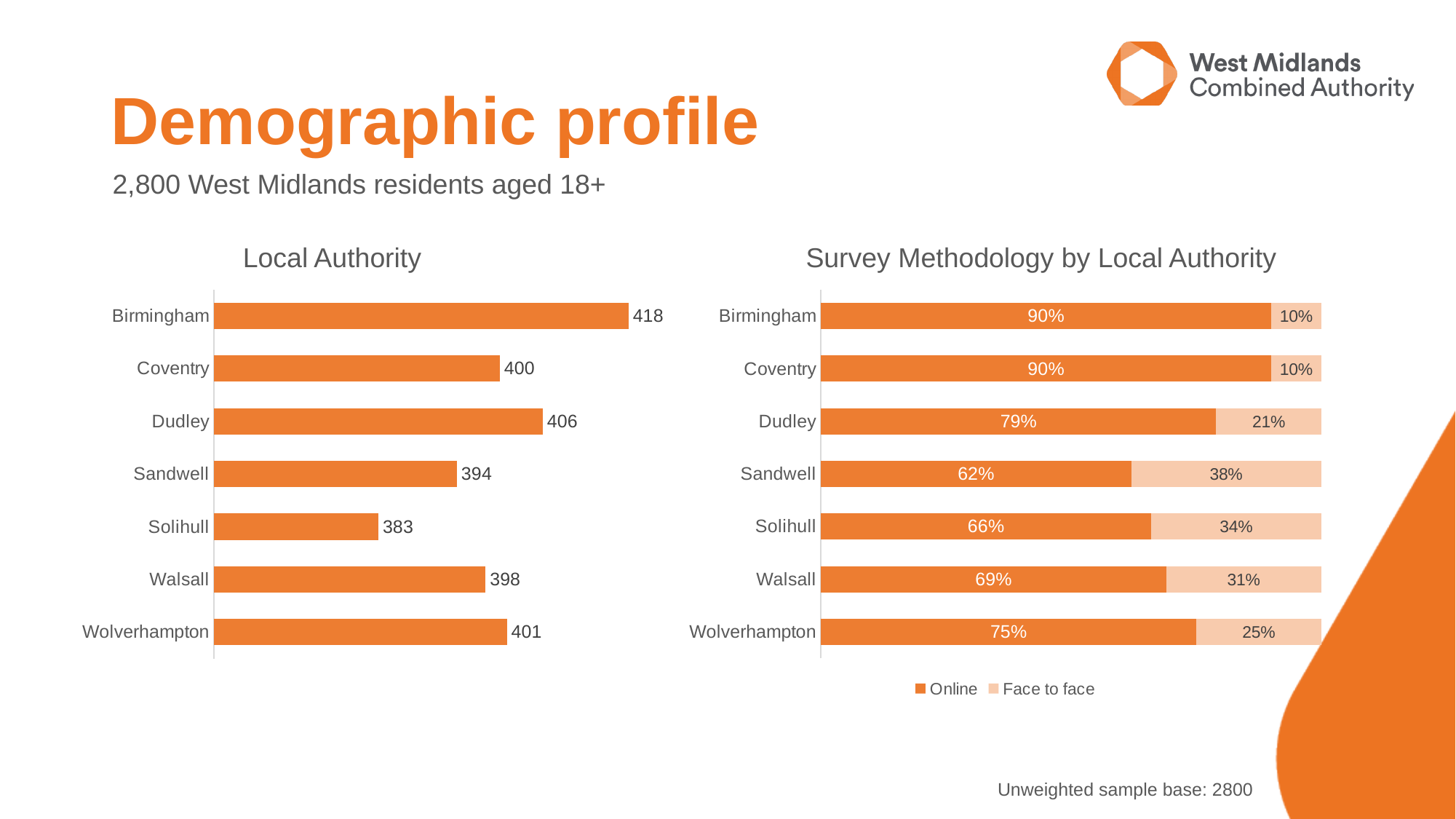
In the 'Local Authority' chart, which local authority has the highest value? Birmingham In the 'Local Authority' chart, what is the value for Birmingham? 418 In the 'Local Authority' chart, which local authority has the lowest value? Solihull In the 'Local Authority' chart, what is the difference between the values for Dudley and Sandwell? 12 In the 'Survey Methodology by Local Authority' chart, what is the Face to face percentage for Dudley? 21% In the 'Local Authority' chart, how many local authorities are shown? 7 In the 'Survey Methodology by Local Authority' chart, what is the Online percentage for Sandwell? 62% What kind of chart is the 'Survey Methodology by Local Authority' chart? Stacked bar chart In the 'Local Authority' chart, which is larger, the value for Walsall or the value for Wolverhampton? Wolverhampton In the 'Survey Methodology by Local Authority' chart, which local authority has the highest Face to face percentage? Sandwell In the 'Survey Methodology by Local Authority' chart, how many series does the legend list? 2 In the 'Survey Methodology by Local Authority' chart, what is the difference between the Online percentages for Birmingham and Wolverhampton? 15%